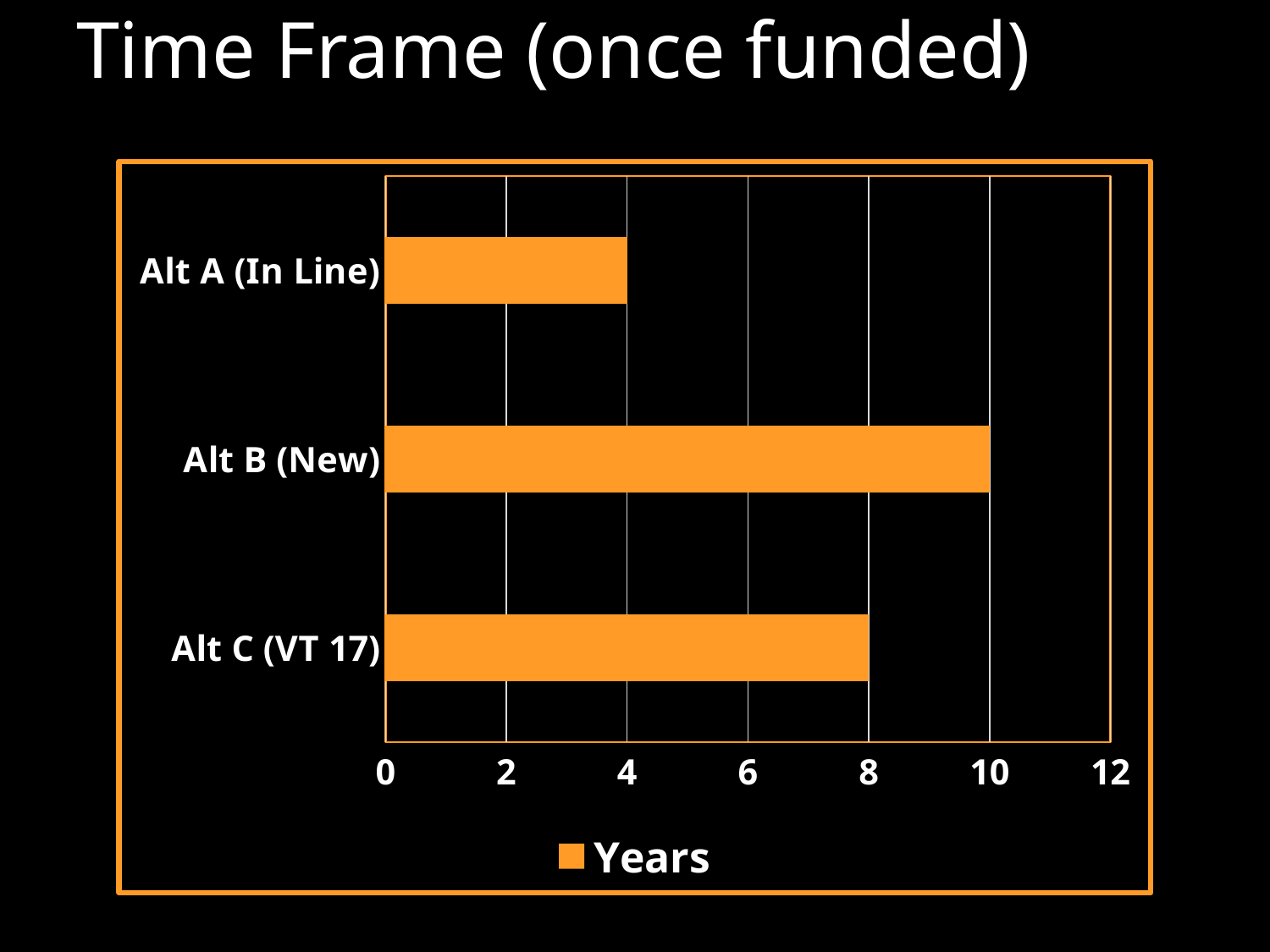
What series name does the legend show? Years What is the difference between the values for Alt B (New) and Alt C (VT 17)? 2 Which category has the highest value? Alt B (New) What is the difference between the values for Alt B (New) and Alt A (In Line)? 6 What is the value for Alt B (New)? 10 Which category has the lowest value? Alt A (In Line) Is the value for Alt B (New) greater or less than 6? greater What is the value for Alt A (In Line)? 4 What is the value for Alt C (VT 17)? 8 Which is larger, the value for Alt C (VT 17) or the value for Alt A (In Line)? Alt C (VT 17) How many categories are shown in the chart? 3 What kind of chart is shown on the slide? Bar chart